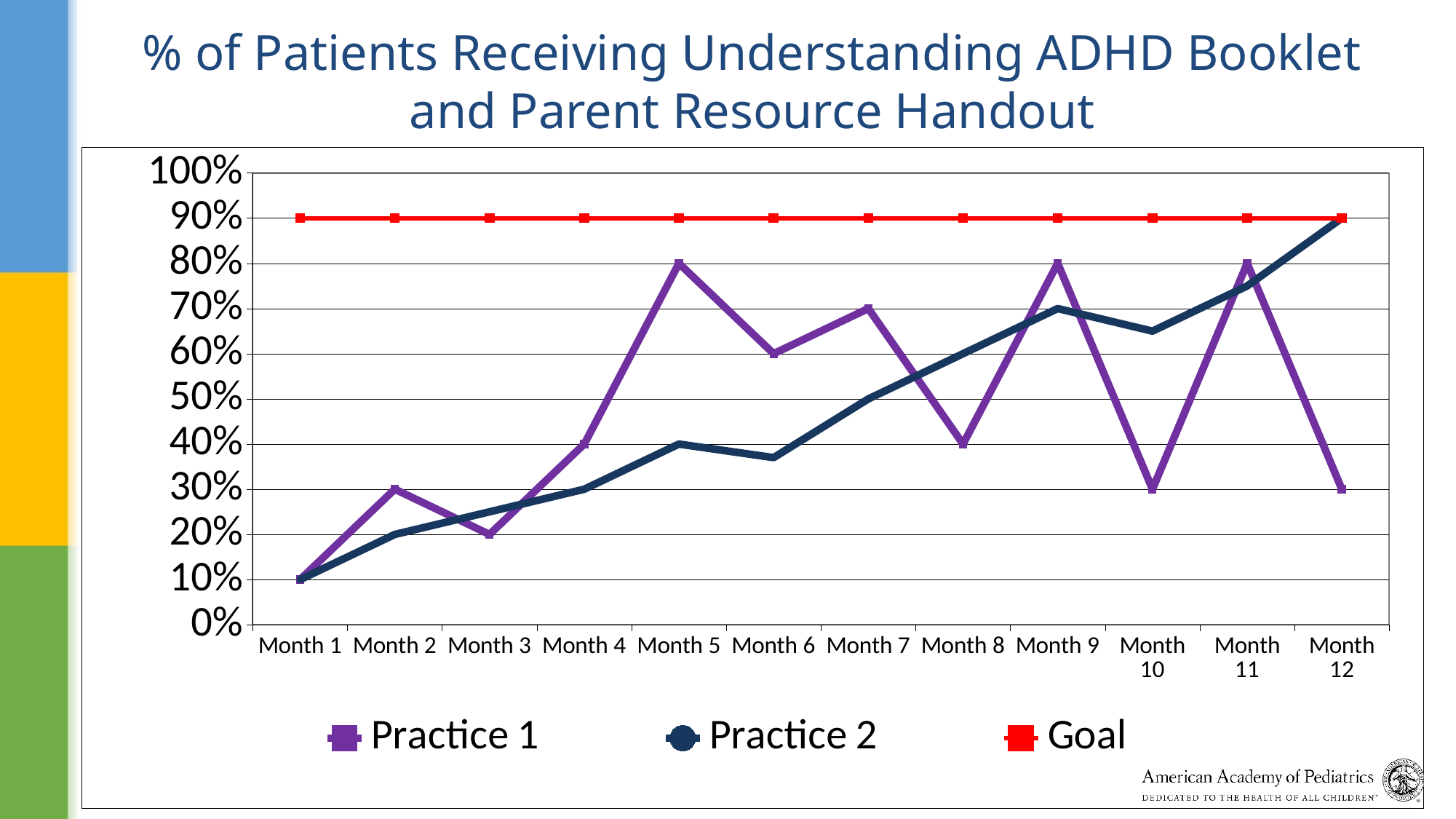
How many months are shown on the x axis? 12 Is the value for Practice 2 in Month 10 greater or less than 60%? greater Does the Practice 2 line generally rise or fall from Month 1 to Month 12? Rise What kind of chart is shown on the slide? Line chart What is the value for Practice 1 in Month 5? 80% What colour is the Goal line? Red What is the value for Practice 2 in Month 12? 90% Which is larger in Month 12, Practice 1 or Practice 2? Practice 2 Is the value for Practice 1 in Month 12 greater or less than 40%? less How many series does the legend list? 3 Which is larger in Month 5, Practice 1 or Practice 2? Practice 1 What is the value of the Goal line? 90%